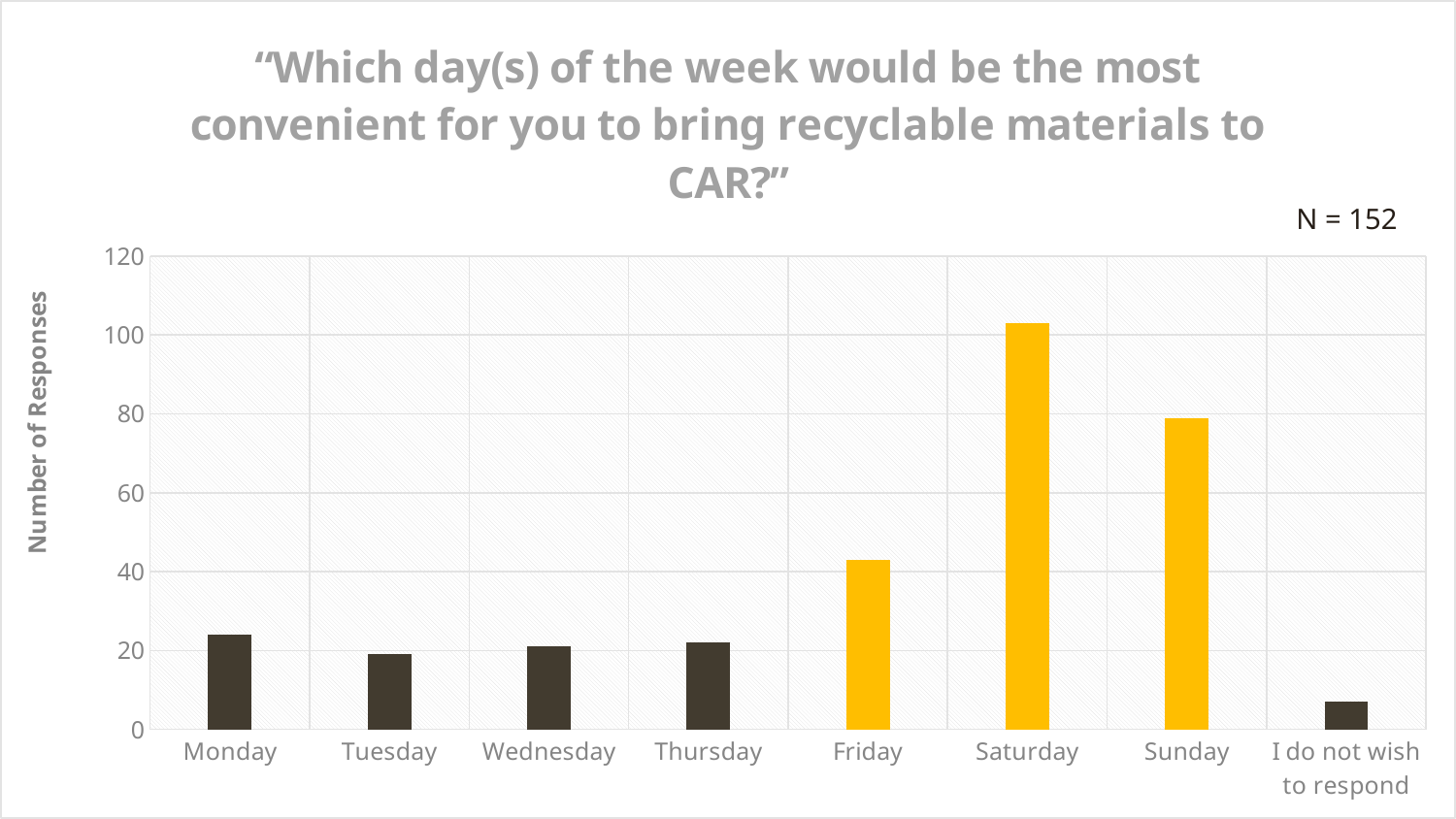
Is the value for Sunday greater or less than 60? greater Which has more responses, Saturday or Sunday? Saturday How many categories are shown on the x axis? 8 Is the value for Saturday greater or less than 80? greater Is the value for Wednesday greater or less than 40? less What is the value of N shown on the slide? 152 Which category has the lowest number of responses? I do not wish to respond Which has more responses, Friday or Monday? Friday What is the title of the vertical axis? Number of Responses Which day has the highest number of responses? Saturday What kind of chart is shown on the slide? Bar chart